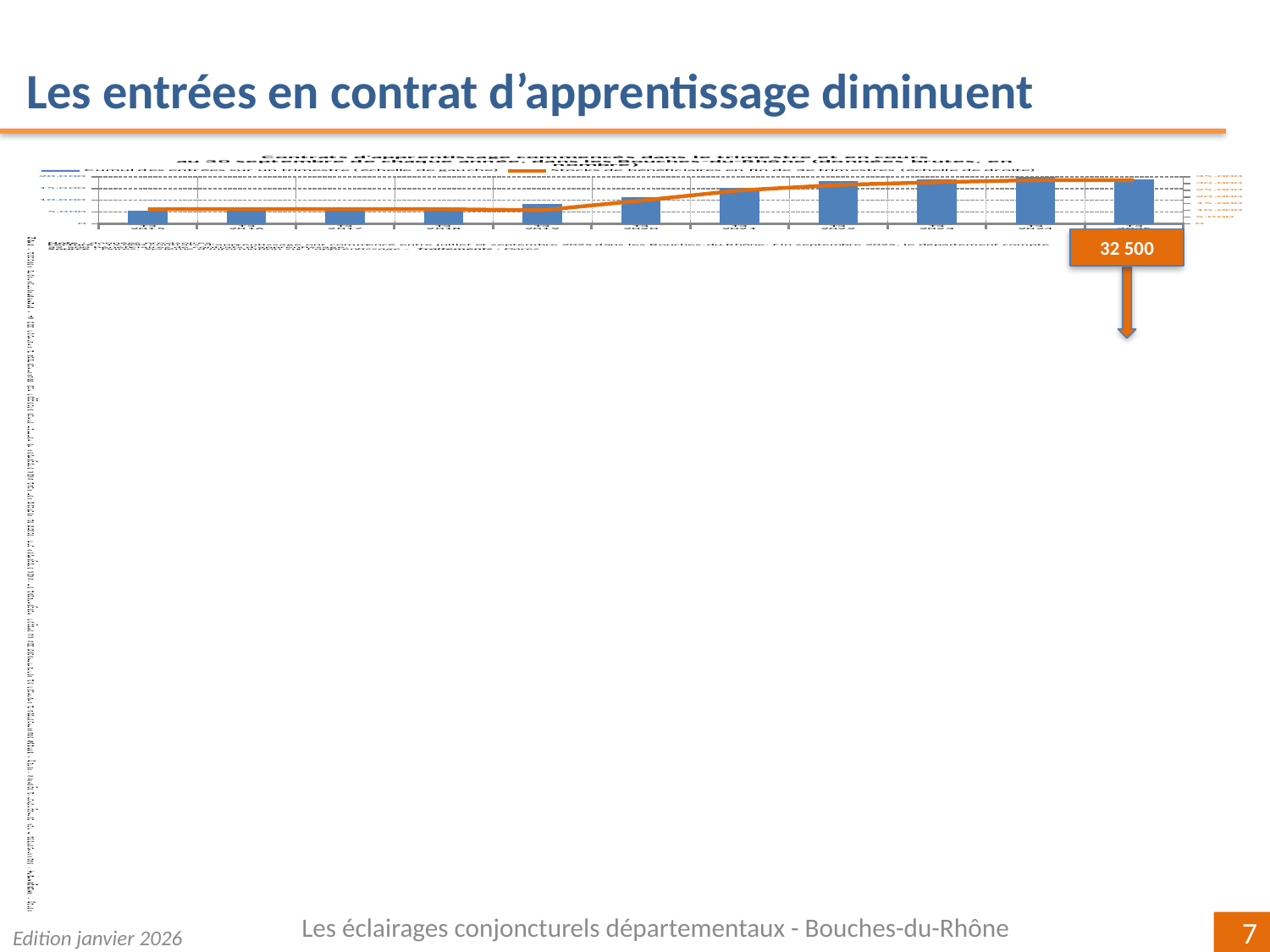
Which is larger, the blue bar for 2022 or the blue bar for 2018? 2022 What kind of chart is shown on the slide? A bar chart with a line series Which is larger, the blue bar for 2025 or the blue bar for 2015? 2025 Which year is the first category on the x axis? 2015 Which year is the last category on the x axis? 2025 How many series does the legend list? 2 Do the blue bars generally rise or fall from 2015 to 2025? Rise Does the orange line rise or fall from 2015 to 2025? Rise Which is larger, the blue bar for 2021 or the blue bar for 2016? 2021 How many years are shown on the x axis? 11